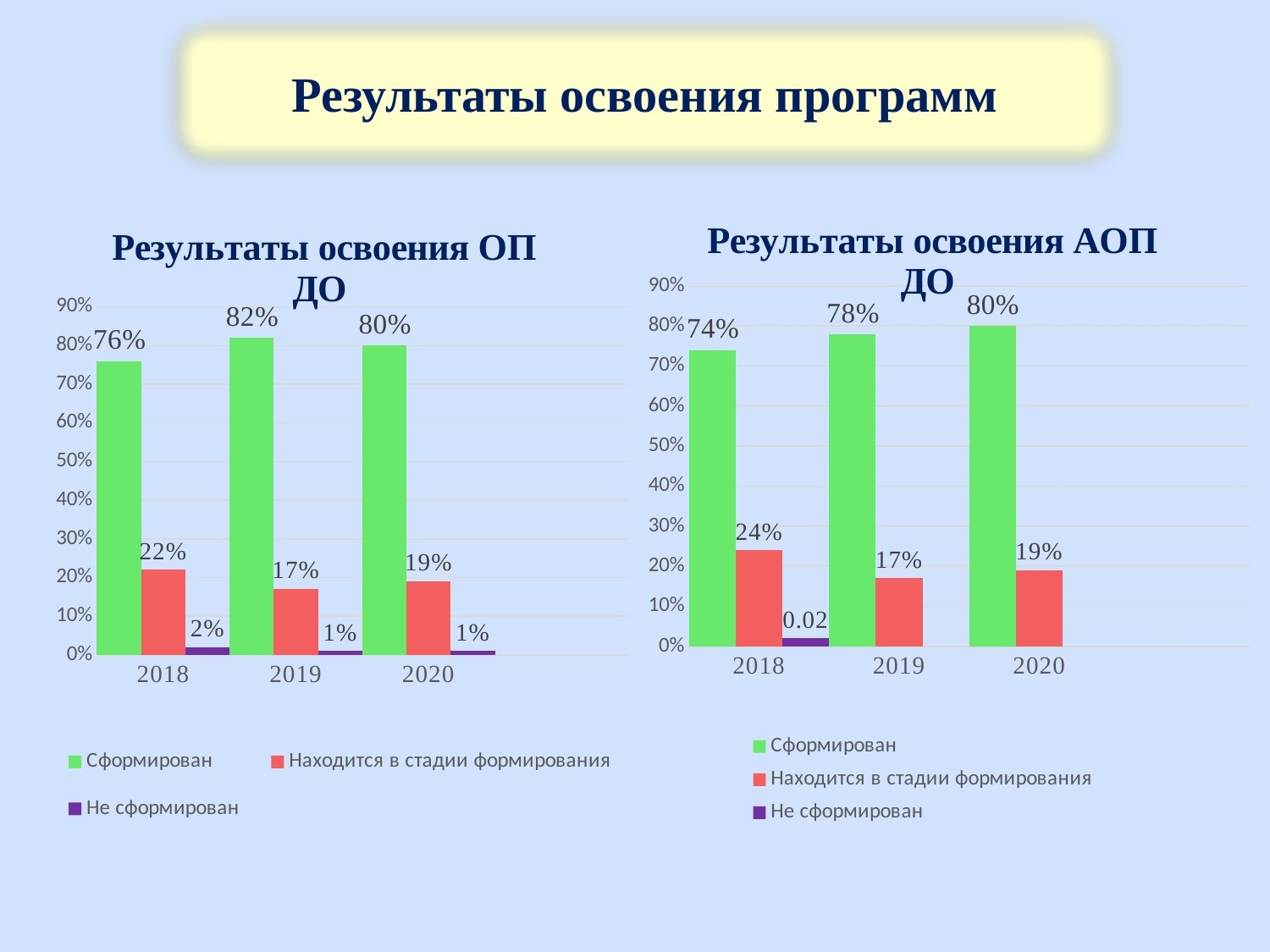
In the chart 'Результаты освоения ОП ДО', what is the value for 'Не сформирован' in 2018? 2% In the chart 'Результаты освоения АОП ДО', which is larger: 'Находится в стадии формирования' in 2018 or in 2020? 2018 In the chart 'Результаты освоения АОП ДО', which year has the lowest value for 'Сформирован'? 2018 In the chart 'Результаты освоения ОП ДО', what is the value for 'Сформирован' in 2019? 82% What type of chart is 'Результаты освоения ОП ДО'? Bar chart In the chart 'Результаты освоения АОП ДО', what is the value for 'Сформирован' in 2020? 80% In the chart 'Результаты освоения ОП ДО', which year has the highest value for 'Сформирован'? 2019 In the chart 'Результаты освоения АОП ДО', does the value for 'Сформирован' rise or fall from 2018 to 2020? Rise In the chart 'Результаты освоения ОП ДО', how many years are shown on the x axis? 3 In the chart 'Результаты освоения АОП ДО', how many series does the legend list? 3 In the chart 'Результаты освоения АОП ДО', what is the value for 'Находится в стадии формирования' in 2018? 24% In the chart 'Результаты освоения ОП ДО', what is the difference between the 'Сформирован' values for 2019 and 2018? 6%